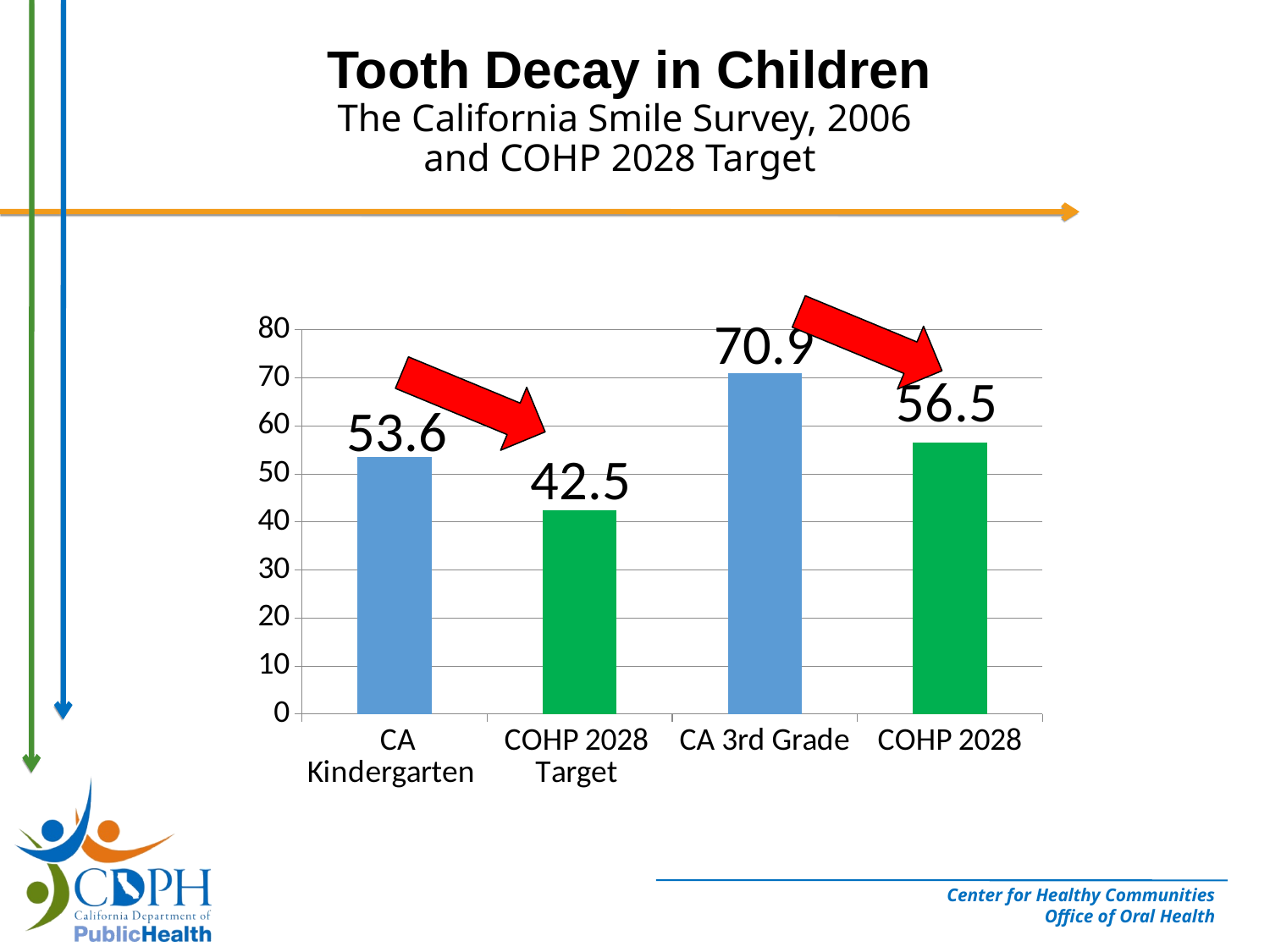
What is the value of the COHP 2028 bar next to CA 3rd Grade? 56.5 What is the value for CA Kindergarten? 53.6 What is the value of the COHP 2028 Target bar next to CA Kindergarten? 42.5 What kind of chart is shown on the slide? Bar chart Is the value for CA 3rd Grade greater or less than 60? greater Which is larger, the value for CA Kindergarten or the value for CA 3rd Grade? CA 3rd Grade How many bars are shown in the chart? 4 What is the difference between the CA 3rd Grade value and the CA Kindergarten value? 17.3 What is the difference between the CA Kindergarten value and the COHP 2028 Target value next to it? 11.1 Which category has the lowest value? COHP 2028 Target Which category has the highest value? CA 3rd Grade What is the value for CA 3rd Grade? 70.9